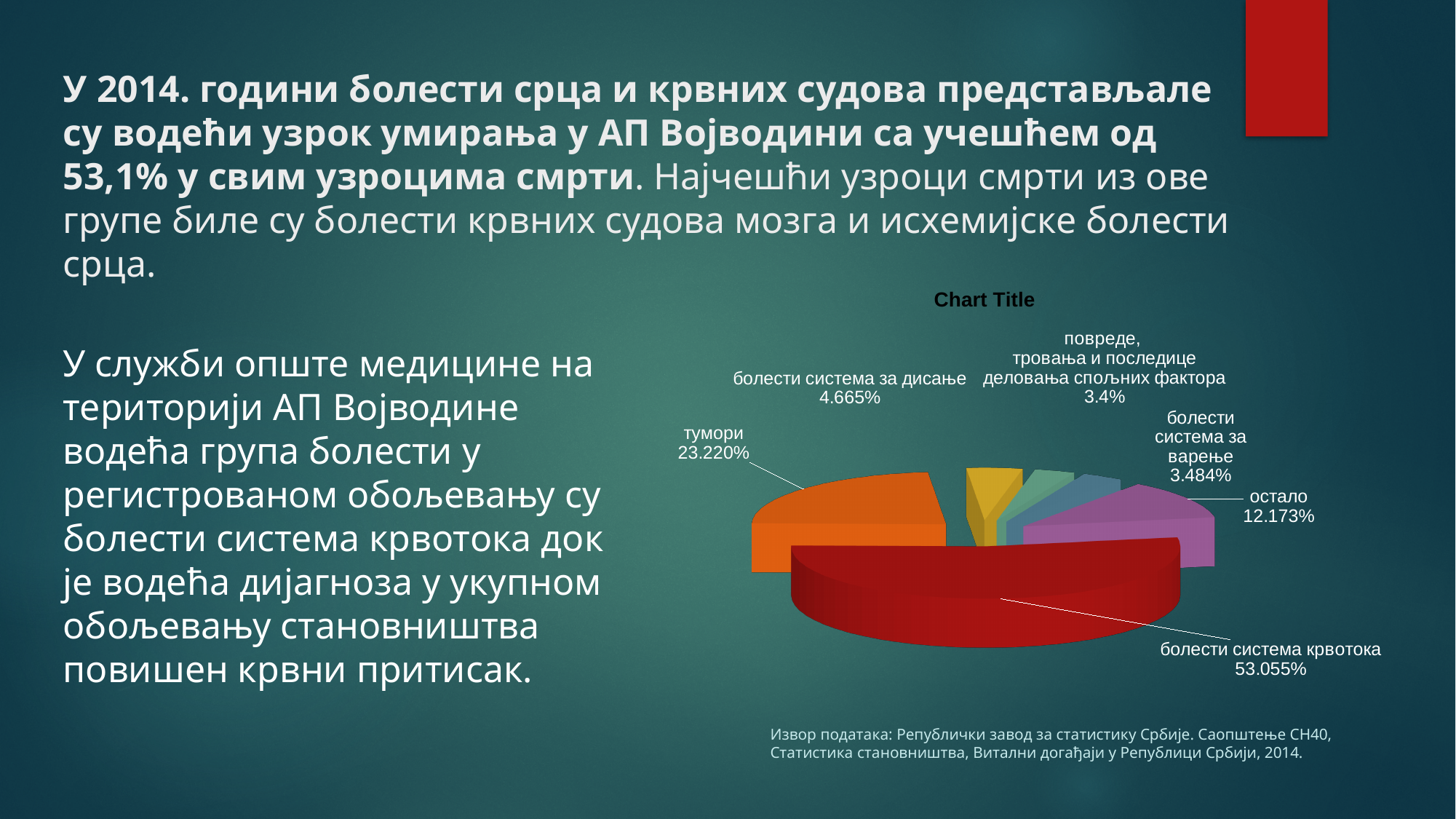
What kind of chart is shown on the slide? pie chart What share of the pie is labelled for болести система за варење? 3.484% What share of the pie is labelled for болести система крвотока? 53.055% What share of the pie is labelled for болести система за дисање? 4.665% Which category has the largest slice of the pie? болести система крвотока What share of the pie is labelled for остало? 12.173% Which slice is larger: тумори or остало? тумори What share of the pie is labelled for тумори? 23.220% What is the difference in percentage points between болести система крвотока and тумори? 29.835 Which category has the smallest slice of the pie? повреде, тровања и последице деловања спољних фактора How many slices does the pie chart have? 6 What is the title of the chart? Chart Title